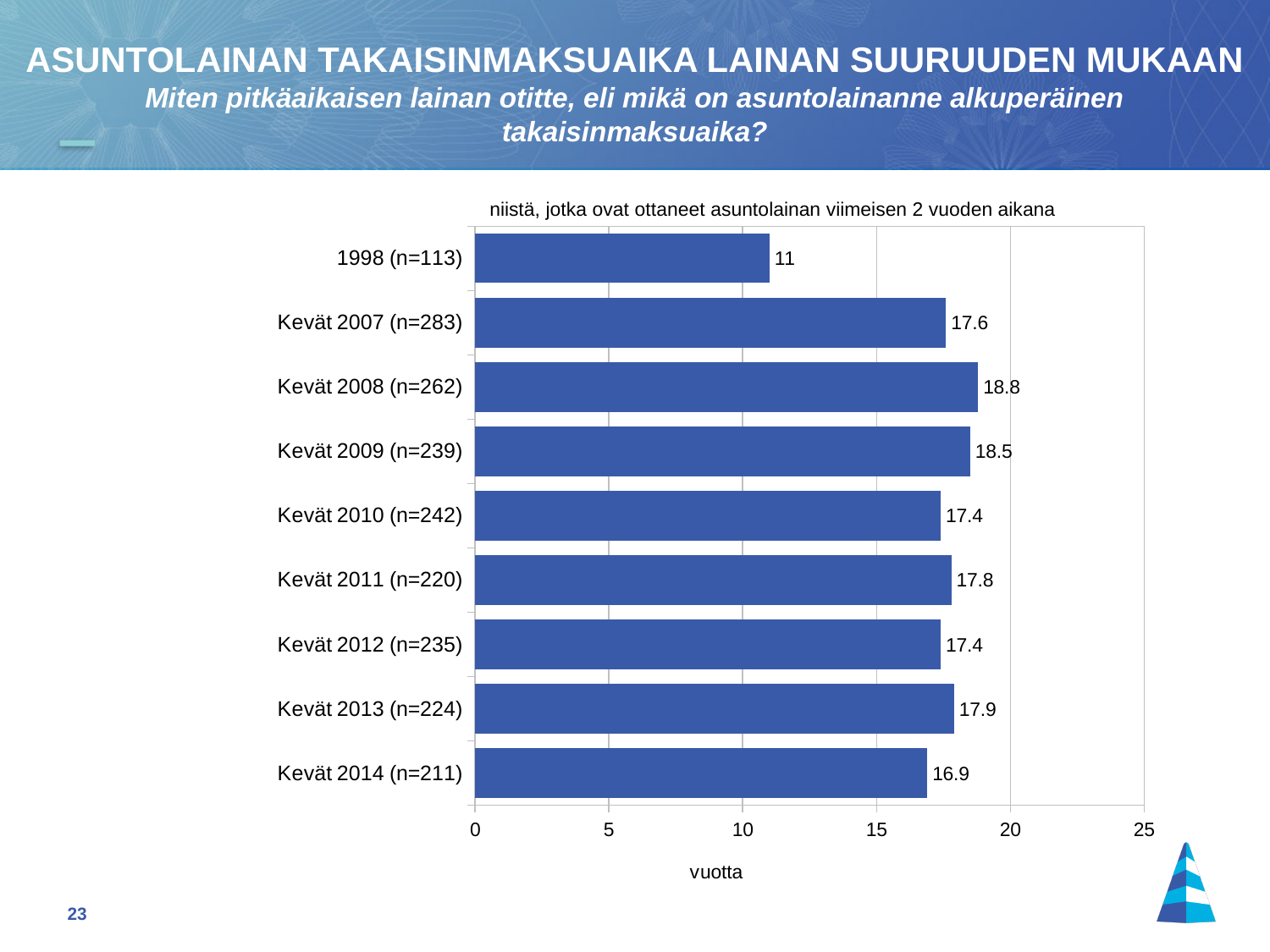
What is the value for Kevät 2011 (n=220)? 17.8 What is the value for 1998 (n=113)? 11 How many categories are shown in the chart? 9 What kind of chart is shown on the slide? bar chart What is the difference between the values for Kevät 2008 (n=262) and 1998 (n=113)? 7.8 Which category has the highest value? Kevät 2008 (n=262) Which category has the lowest value? 1998 (n=113) What is the value for Kevät 2008 (n=262)? 18.8 What is the value for Kevät 2014 (n=211)? 16.9 Which is larger, the value for Kevät 2013 (n=224) or Kevät 2014 (n=211)? Kevät 2013 (n=224) What is the label on the horizontal axis of the chart? vuotta Is the value for Kevät 2009 (n=239) greater or less than 15? greater